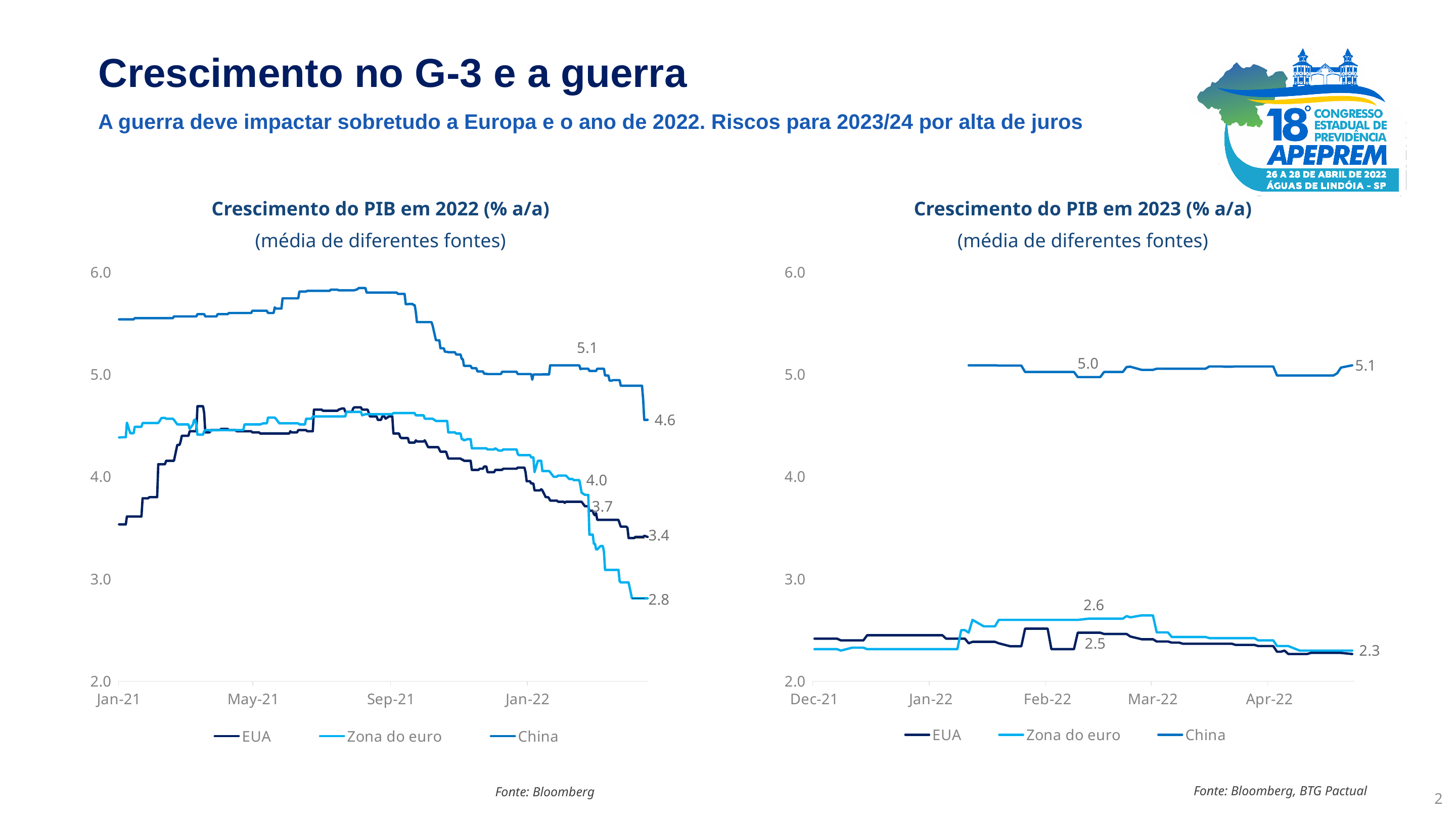
In the left chart, 'Crescimento do PIB em 2022 (% a/a)', does the Zona do euro series rise or fall over the last months shown? fall In the left chart, 'Crescimento do PIB em 2022 (% a/a)', which series has the highest value at the end of the period? China In the left chart, 'Crescimento do PIB em 2022 (% a/a)', what is the final labelled value for China? 4.6 In the left chart, 'Crescimento do PIB em 2022 (% a/a)', what is the final labelled value for EUA? 3.4 How many series does the legend of the left chart, 'Crescimento do PIB em 2022 (% a/a)', list? 3 In the left chart, 'Crescimento do PIB em 2022 (% a/a)', what is the final labelled value for Zona do euro? 2.8 In the right chart, 'Crescimento do PIB em 2023 (% a/a)', what is the final labelled value shared by EUA and Zona do euro? 2.3 In the right chart, 'Crescimento do PIB em 2023 (% a/a)', is the value for China in Apr-22 greater or less than 4.0? greater In the left chart, 'Crescimento do PIB em 2022 (% a/a)', by how much did the China series fall from its labelled value of 5.1 to its final labelled value? 0.5 What source is cited below the right chart, 'Crescimento do PIB em 2023 (% a/a)'? Bloomberg, BTG Pactual What kind of chart is the left chart, 'Crescimento do PIB em 2022 (% a/a)'? line chart In the right chart, 'Crescimento do PIB em 2023 (% a/a)', what is the final labelled value for China? 5.1